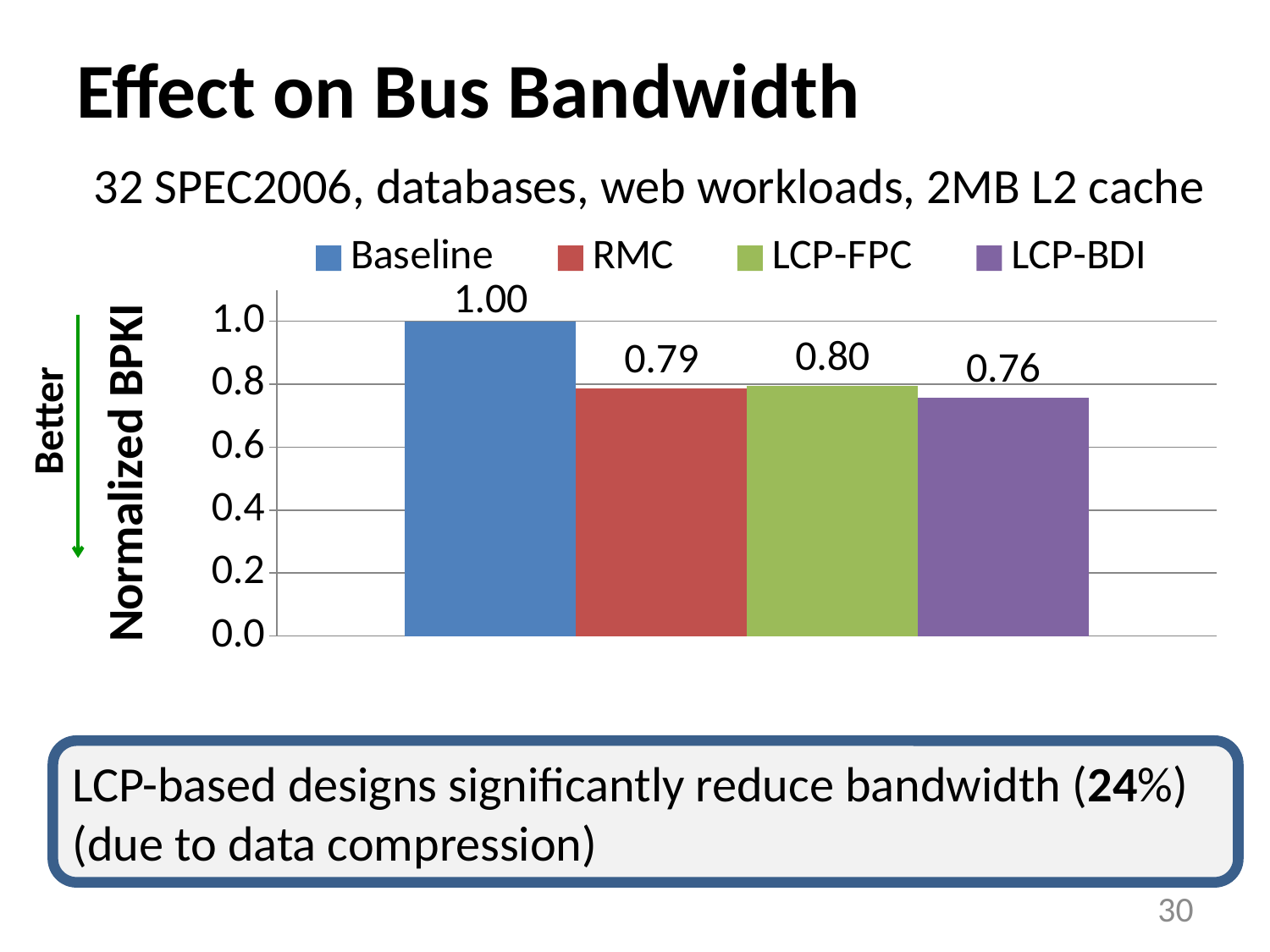
Is the Normalized BPKI value for LCP-BDI greater or less than 0.8? less What is the Normalized BPKI value for LCP-FPC? 0.80 Which series has the highest Normalized BPKI? Baseline What is the Normalized BPKI value for Baseline? 1.00 What is the Normalized BPKI value for LCP-BDI? 0.76 How many series does the legend list? 4 What is the Normalized BPKI value for RMC? 0.79 What is the label of the y axis? Normalized BPKI Which has a larger Normalized BPKI, RMC or LCP-BDI? RMC Which series has the lowest Normalized BPKI? LCP-BDI What kind of chart is shown on the slide? bar chart What is the difference in Normalized BPKI between Baseline and LCP-BDI? 0.24